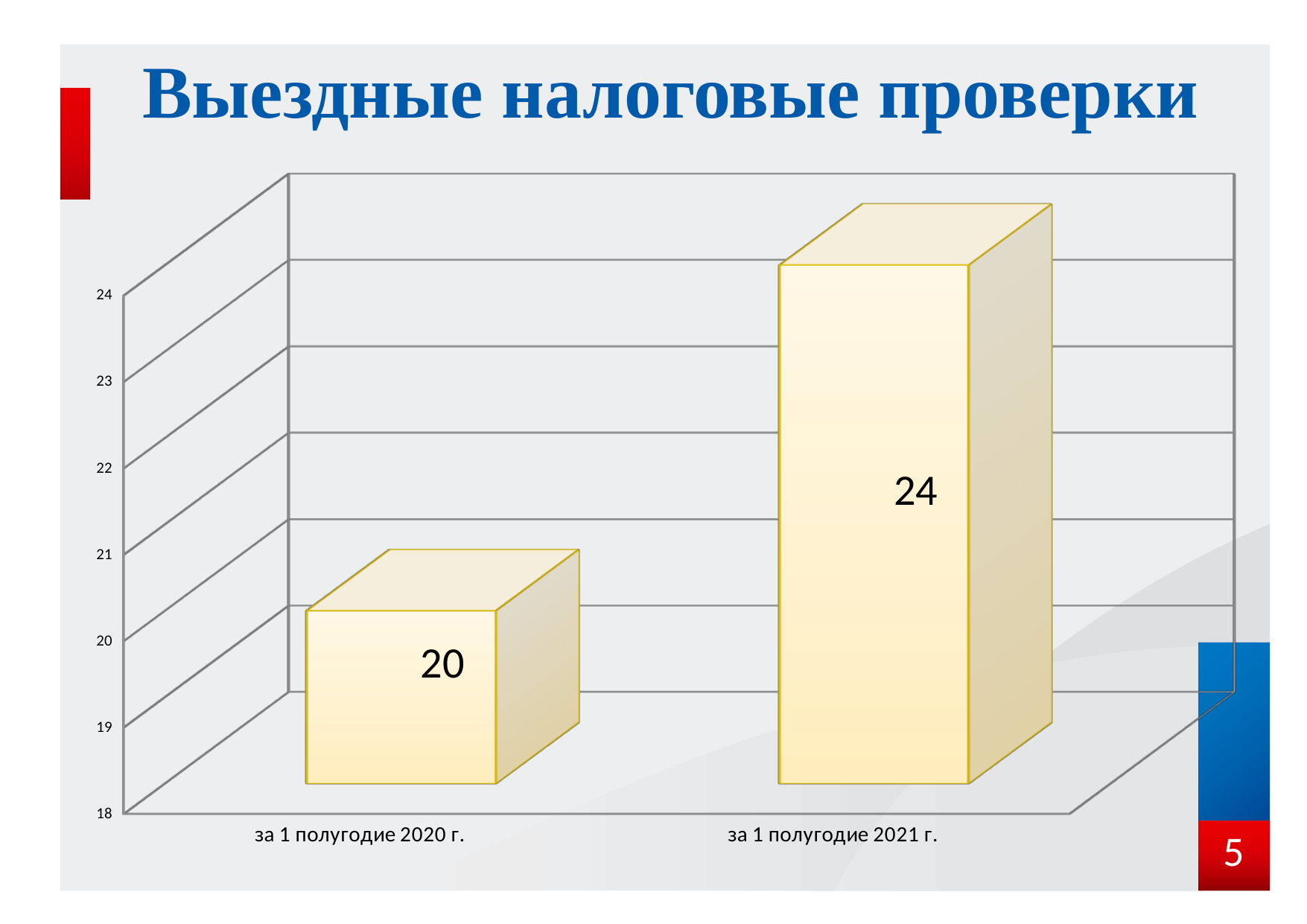
Which category has the lowest value? за 1 полугодие 2020 г. Do the values rise or fall from 2020 to 2021? rise What is the value for "за 1 полугодие 2021 г."? 24 What is the value for "за 1 полугодие 2020 г."? 20 Is the value for "за 1 полугодие 2021 г." greater or less than 22? greater What is the difference between the values for 2021 and 2020? 4 What is the lowest value shown on the vertical axis? 18 How many categories are shown on the chart? 2 Which category has the highest value? за 1 полугодие 2021 г. Which is larger, the value for "за 1 полугодие 2020 г." or for "за 1 полугодие 2021 г."? за 1 полугодие 2021 г. What kind of chart is shown on the slide? bar chart What is the title of the slide? Выездные налоговые проверки